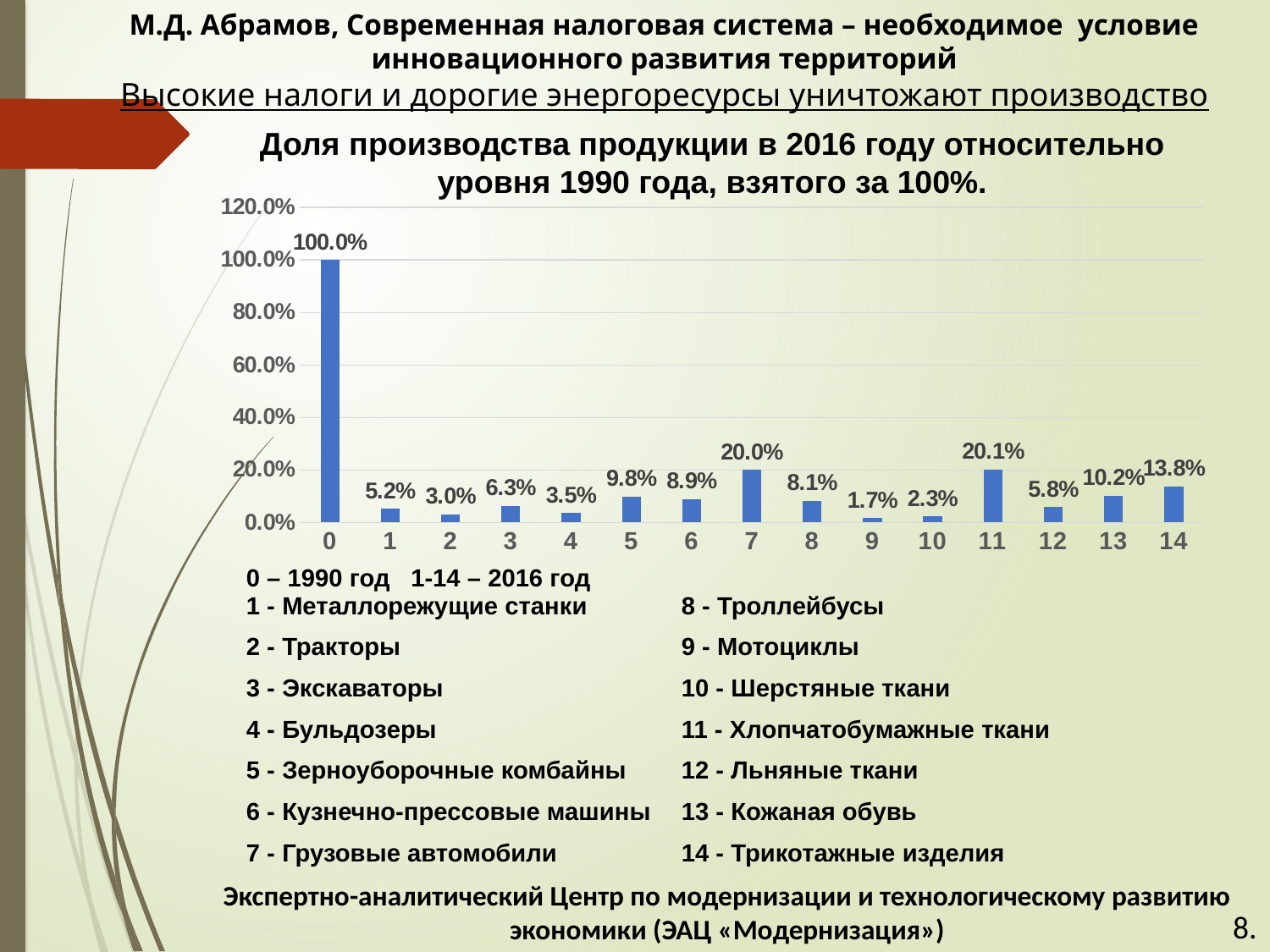
What is the value for category 11 (Хлопчатобумажные ткани)? 20.1% What is the value for category 14 (Трикотажные изделия)? 13.8% Which category has the lowest value on the chart? 9 (Мотоциклы) What kind of chart is shown on the slide? Bar chart What is the value for category 2 (Тракторы)? 3.0% What is the difference between the value for category 0 and the value for category 7? 80.0% What is the value for category 9 (Мотоциклы)? 1.7% What is the difference between the value for category 14 and the value for category 13? 3.6% Which category has the highest value on the chart? 0 (1990 год) How many bars are plotted on the chart? 15 What is the value for category 7 (Грузовые автомобили)? 20.0% Which is larger, the value for category 5 (Зерноуборочные комбайны) or category 6 (Кузнечно-прессовые машины)? Category 5 (Зерноуборочные комбайны)